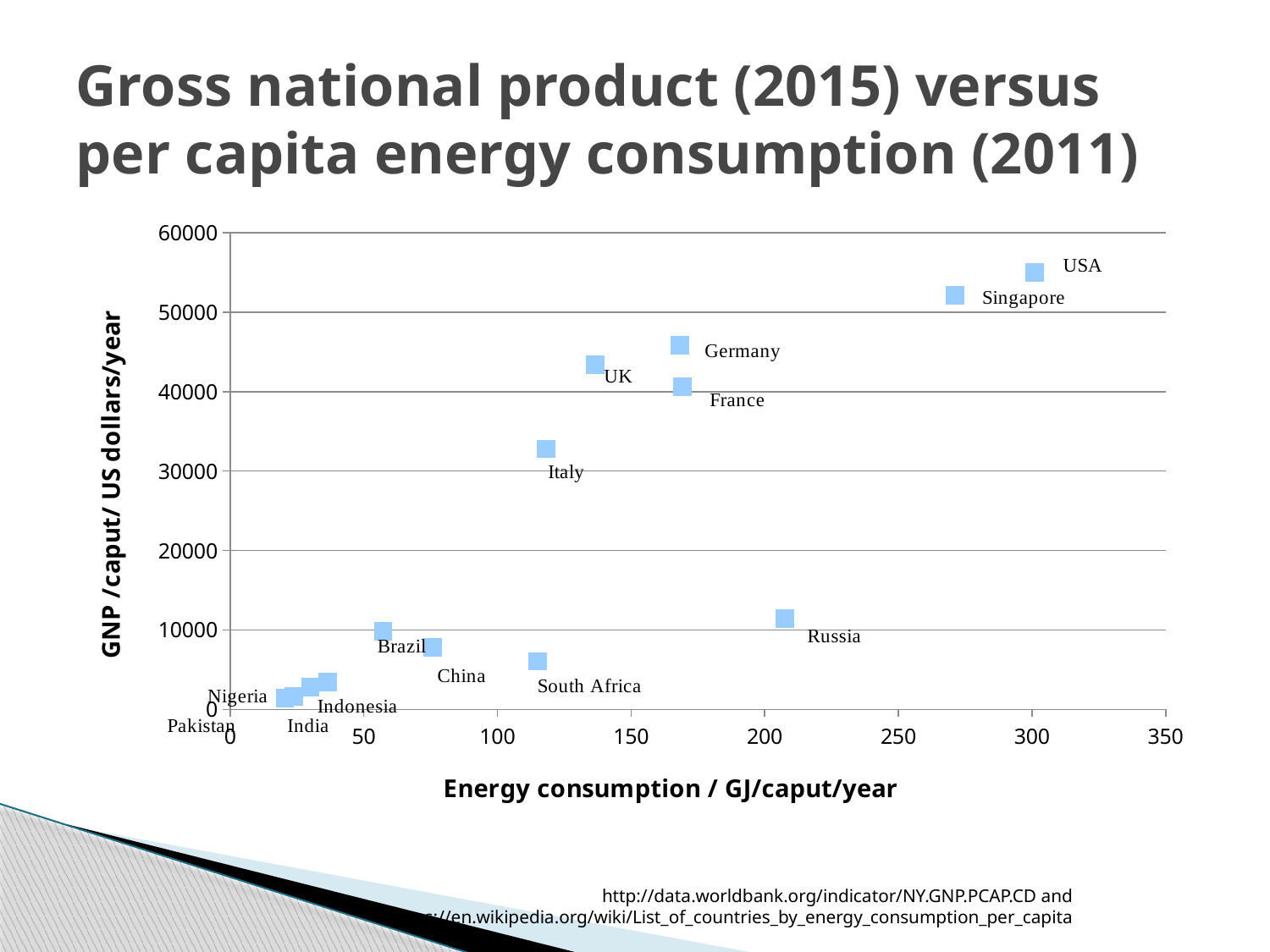
What is the label of the x axis? Energy consumption / GJ/caput/year Is the GNP per caput for Italy greater or less than 30000? greater Is the GNP per caput for the USA greater or less than 50000? greater What is the label of the y axis? GNP /caput/ US dollars/year Which has the higher GNP per caput, Russia or Italy? Italy Is the GNP per caput for China greater or less than 10000? less Which country has the highest GNP per caput on the chart? USA Which has the higher GNP per caput, Germany or France? Germany What kind of chart is shown on the slide? scatter chart Which country has the highest energy consumption per caput on the chart? USA